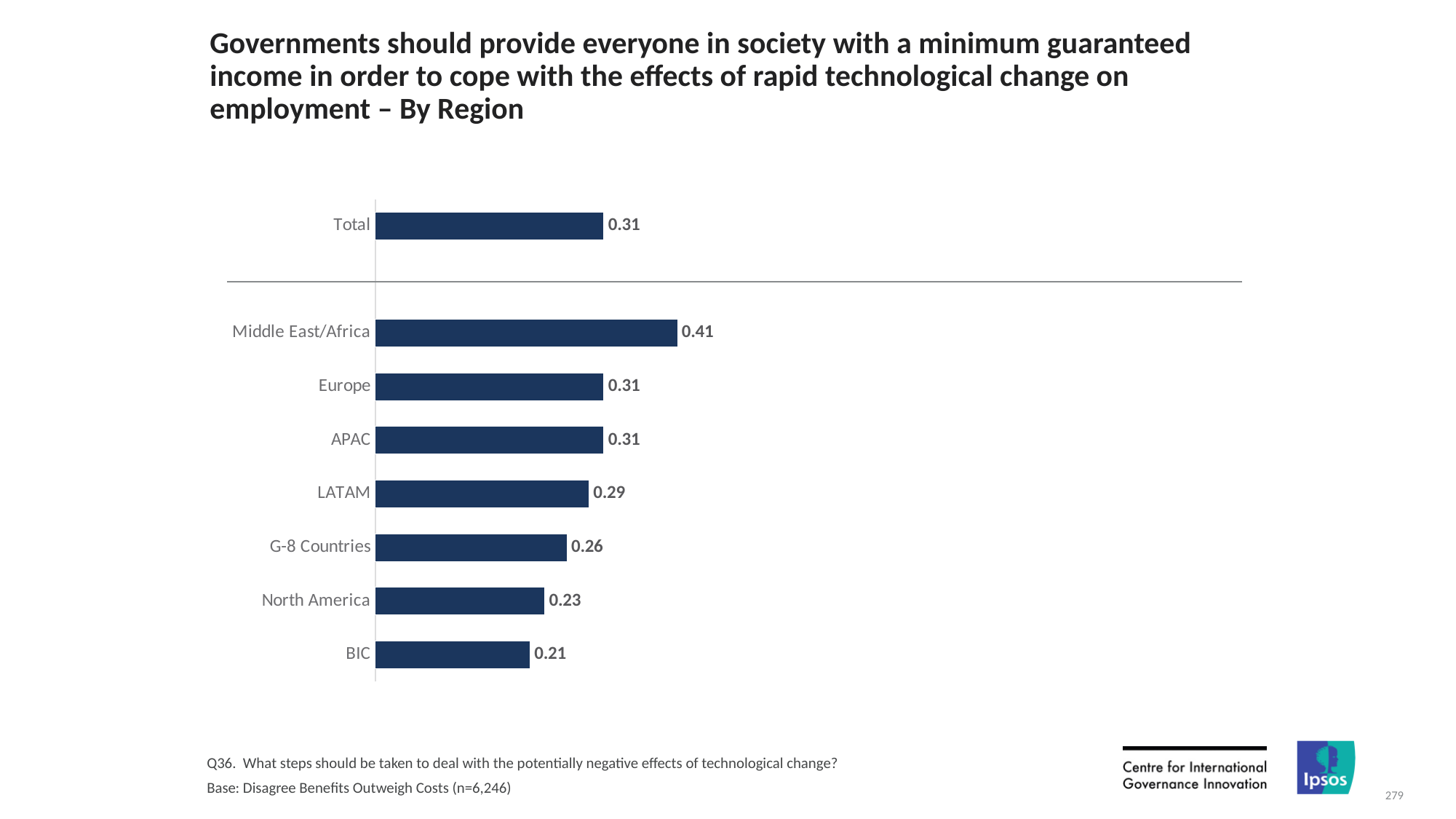
What is the value for Middle East/Africa? 0.41 What kind of chart is shown on the slide? Bar chart What is the value for North America? 0.23 Which is larger, the value for LATAM or the value for G-8 Countries? LATAM What is the value for G-8 Countries? 0.26 Which region has the lowest value? BIC How many bars are shown in the chart? 8 What is the difference between the values for LATAM and North America? 0.06 What is the value for Total? 0.31 Which region has the highest value? Middle East/Africa What is the difference between the values for Middle East/Africa and BIC? 0.20 What is the base described in the footnote of the slide? Disagree Benefits Outweigh Costs (n=6,246)